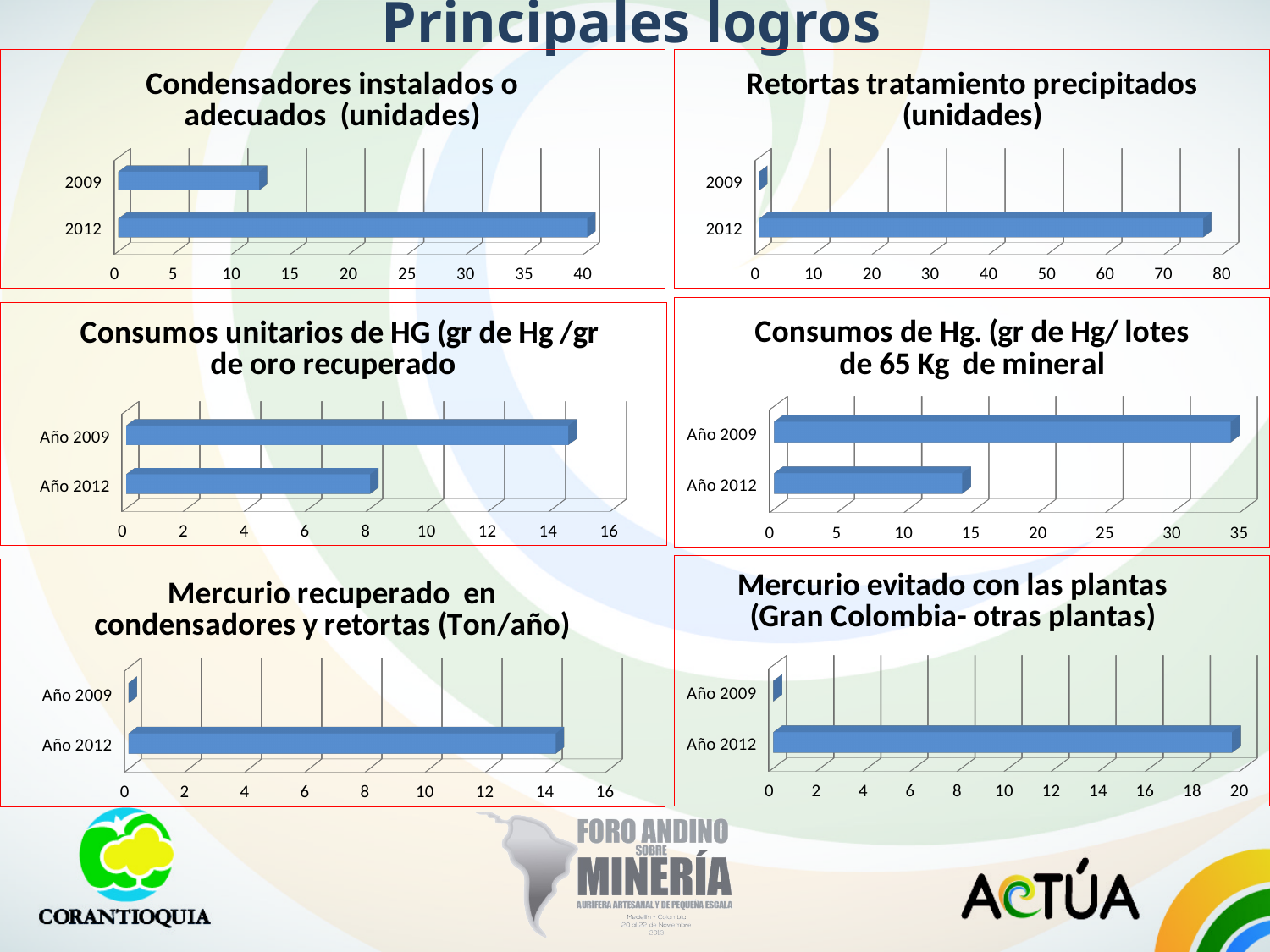
In the chart titled "Condensadores instalados o adecuados (unidades)", is the value for 2009 greater or less than 15? less In the chart titled "Consumos de Hg. (gr de Hg/ lotes de 65 Kg de mineral", do the values rise or fall from Año 2009 to Año 2012? fall What kind of chart is the chart titled "Retortas tratamiento precipitados (unidades)"? bar chart In the chart titled "Consumos unitarios de HG (gr de Hg /gr de oro recuperado", is the value for Año 2012 greater or less than 10? less In the chart titled "Mercurio evitado con las plantas (Gran Colombia- otras plantas)", is the value for Año 2009 greater or less than 2? less In the chart titled "Retortas tratamiento precipitados (unidades)", which year has the lower value? 2009 How many categories are plotted in the chart titled "Mercurio evitado con las plantas (Gran Colombia- otras plantas)"? 2 In the chart titled "Condensadores instalados o adecuados (unidades)", which year has the higher value? 2012 In the chart titled "Consumos unitarios de HG (gr de Hg /gr de oro recuperado", which year has the higher value, Año 2009 or Año 2012? Año 2009